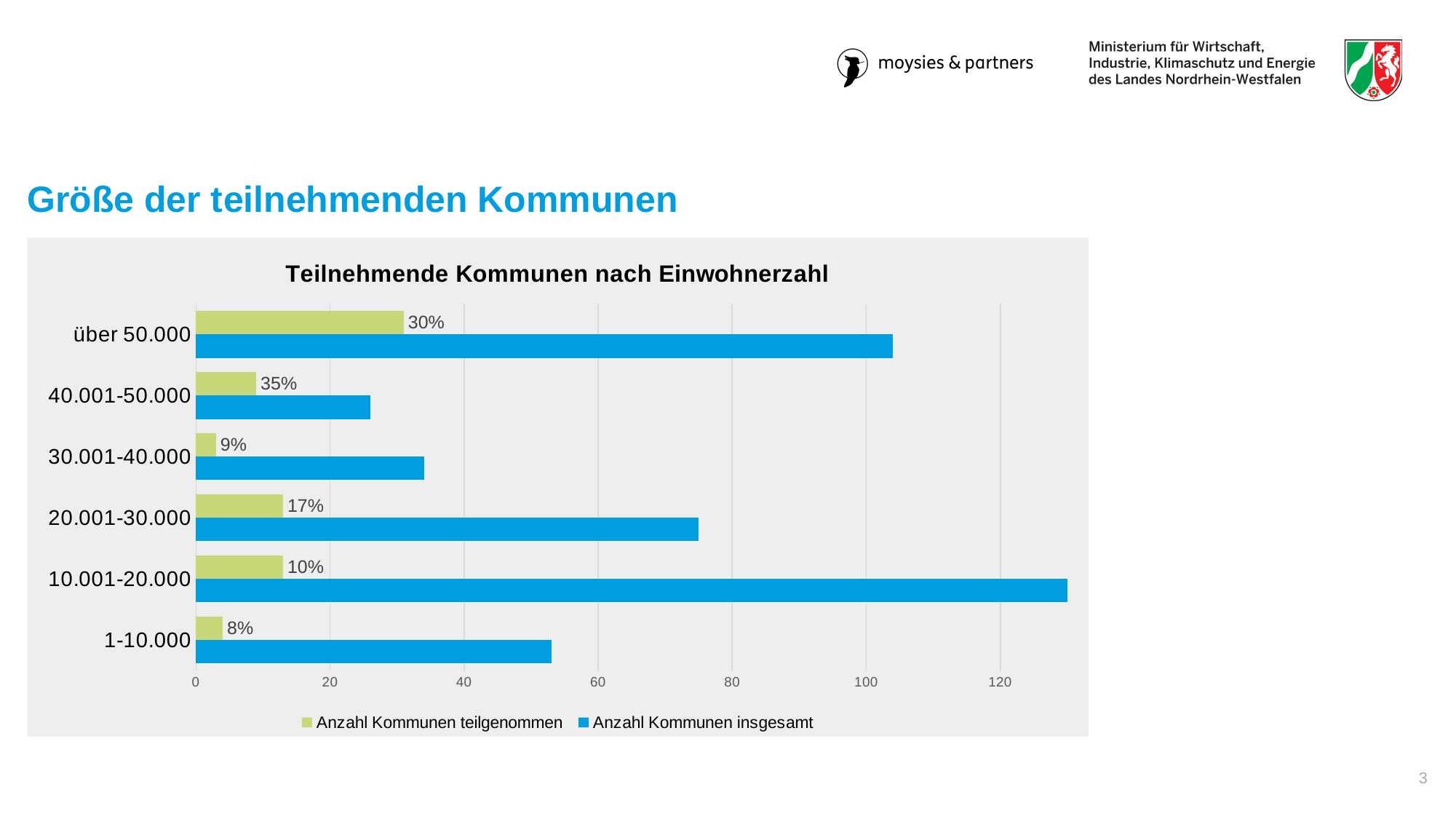
What percentage label is shown for the 'Anzahl Kommunen teilgenommen' bar in the category 1-10.000? 8% Is the value for 'Anzahl Kommunen insgesamt' in the category über 50.000 greater or less than 100? greater What is the title of the chart? Teilnehmende Kommunen nach Einwohnerzahl What percentage label is shown for the 'Anzahl Kommunen teilgenommen' bar in the category 40.001-50.000? 35% How many population-size categories are shown on the chart? 6 What type of chart is shown on the slide? bar chart Which category has the highest value for 'Anzahl Kommunen insgesamt'? 10.001-20.000 What percentage label is shown for the 'Anzahl Kommunen teilgenommen' bar in the category über 50.000? 30% Is the value for 'Anzahl Kommunen insgesamt' in the category 20.001-30.000 greater or less than 80? less How many series does the legend list? 2 Which is larger: the 'Anzahl Kommunen insgesamt' value for 1-10.000 or for 30.001-40.000? 1-10.000 Which category has the lowest value for 'Anzahl Kommunen insgesamt'? 40.001-50.000